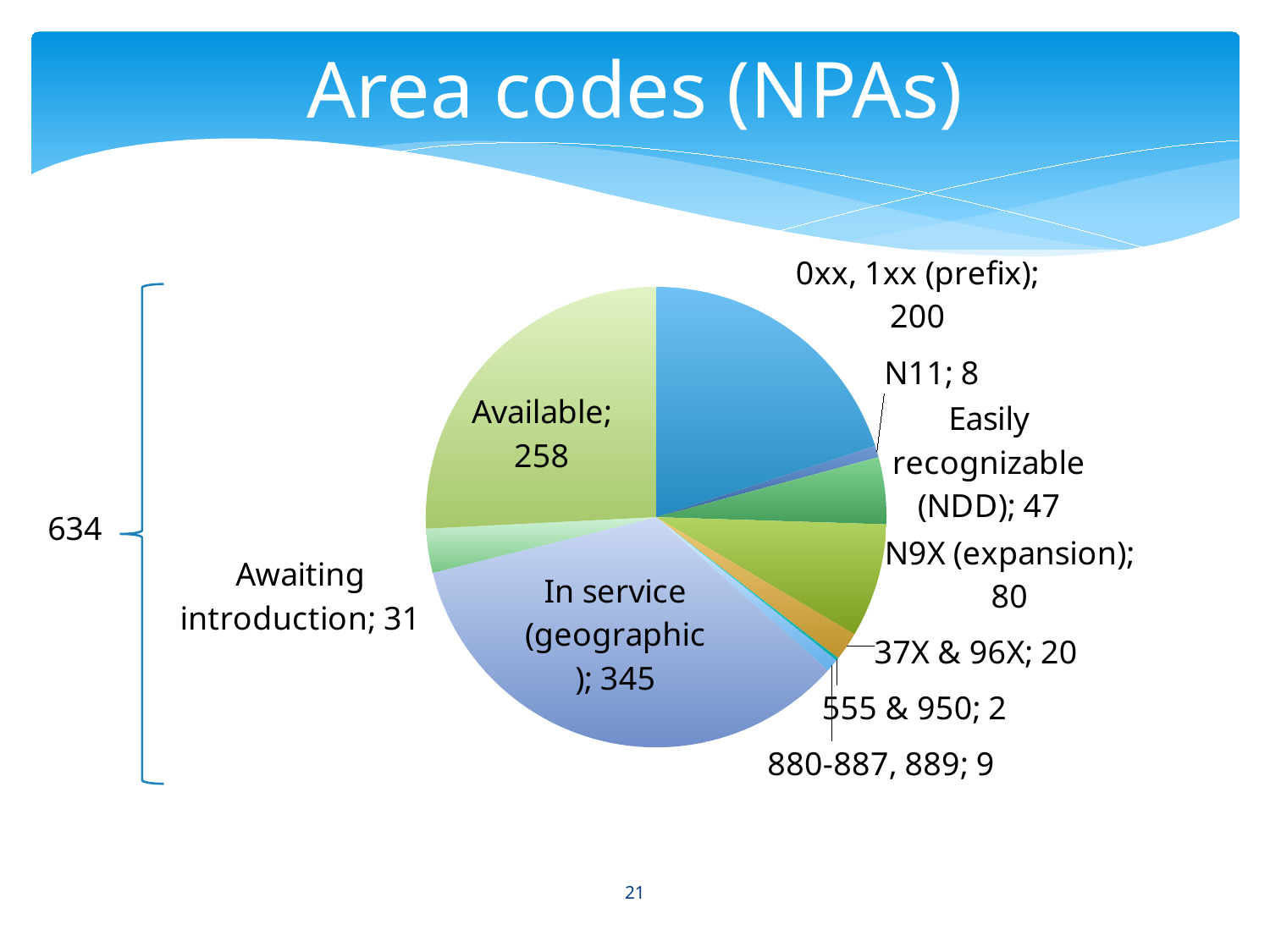
What kind of chart is shown on the slide? pie chart Which category has the largest slice of the pie? In service (geographic) What is the title of the slide containing the pie chart? Area codes (NPAs) How many slices does the pie chart have? 10 What is the value for "555 & 950"? 2 Which is larger, the value for "0xx, 1xx (prefix)" or the value for "N9X (expansion)"? 0xx, 1xx (prefix) What is the value for "N9X (expansion)"? 80 What is the difference between the "In service (geographic)" value and the "Available" value? 87 What is the value for the "In service (geographic)" slice? 345 What is the value for "Easily recognizable (NDD)"? 47 What is the value for the "Available" slice? 258 Which category has the smallest slice of the pie? 555 & 950